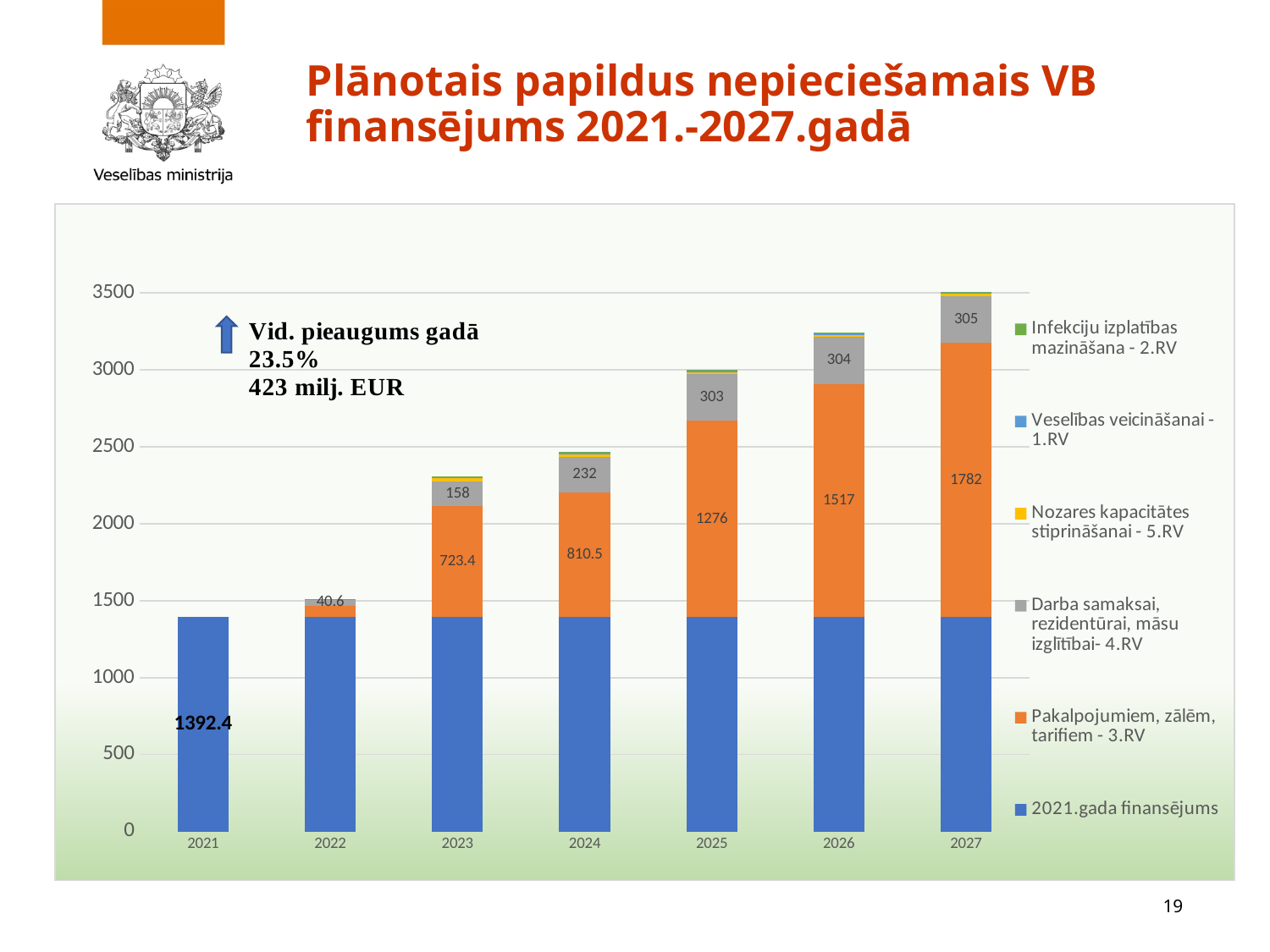
Which year has the highest 'Pakalpojumiem, zālēm, tarifiem - 3.RV' value? 2027 What is the value of the 'Pakalpojumiem, zālēm, tarifiem - 3.RV' segment for 2027? 1782 Do the total bar heights rise or fall from 2021 to 2027? rise What kind of chart is shown on the slide? bar chart Is the total height of the 2027 bar greater or less than 3000? greater Which year has the larger 'Darba samaksai, rezidentūrai, māsu izglītībai- 4.RV' value, 2023 or 2024? 2024 How many years are shown on the x axis of the chart? 7 How many series does the chart legend list? 6 What is the value of the 'Darba samaksai, rezidentūrai, māsu izglītībai- 4.RV' segment for 2025? 303 What is the difference between the 'Pakalpojumiem, zālēm, tarifiem - 3.RV' values for 2026 and 2025? 241 What is the value labelled on the 2021 bar? 1392.4